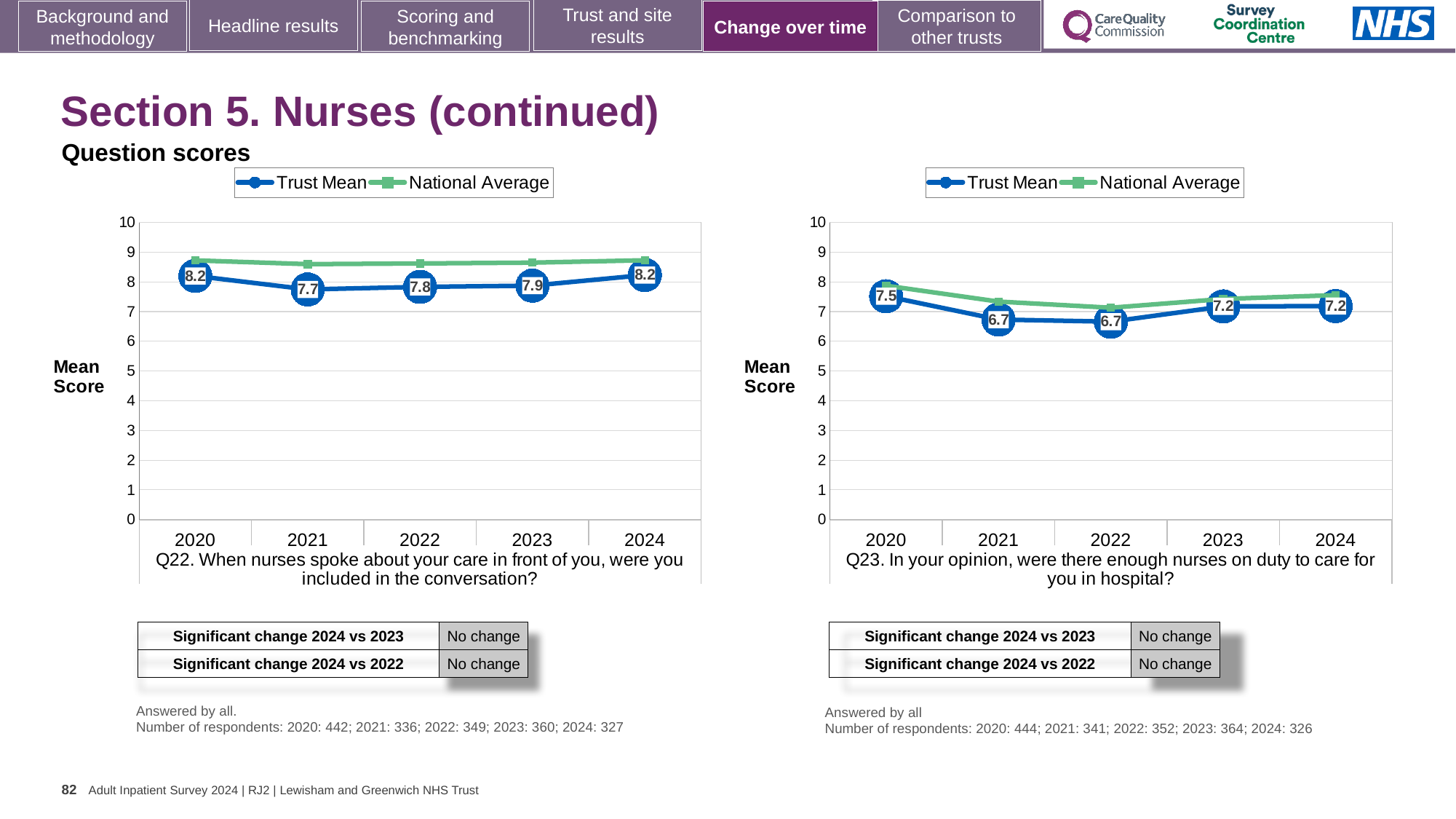
In the Q23 chart (right), which year has the highest Trust Mean score? 2020 How many years are plotted on the x axis of the Q22 chart (left)? 5 How many series does the legend of the Q23 chart (right) list? 2 What type of chart is used for Q22 (left)? Line chart In the Q23 chart (right), is the National Average value for 2020 greater or less than 7? greater In the Q22 chart (left), is the Trust Mean score for 2022 larger or smaller than the Trust Mean score for 2023? smaller In the Q23 chart (right), what is the Trust Mean score for 2023? 7.2 In the Q23 chart (right), what is the Trust Mean score for 2020? 7.5 In the Q22 chart (left), which year has the lowest Trust Mean score? 2021 In the Q23 chart (right), what is the difference between the Trust Mean score in 2020 and in 2021? 0.8 In the Q22 chart (left), what is the Trust Mean score for 2024? 8.2 In the Q22 chart (left), what is the Trust Mean score for 2021? 7.7